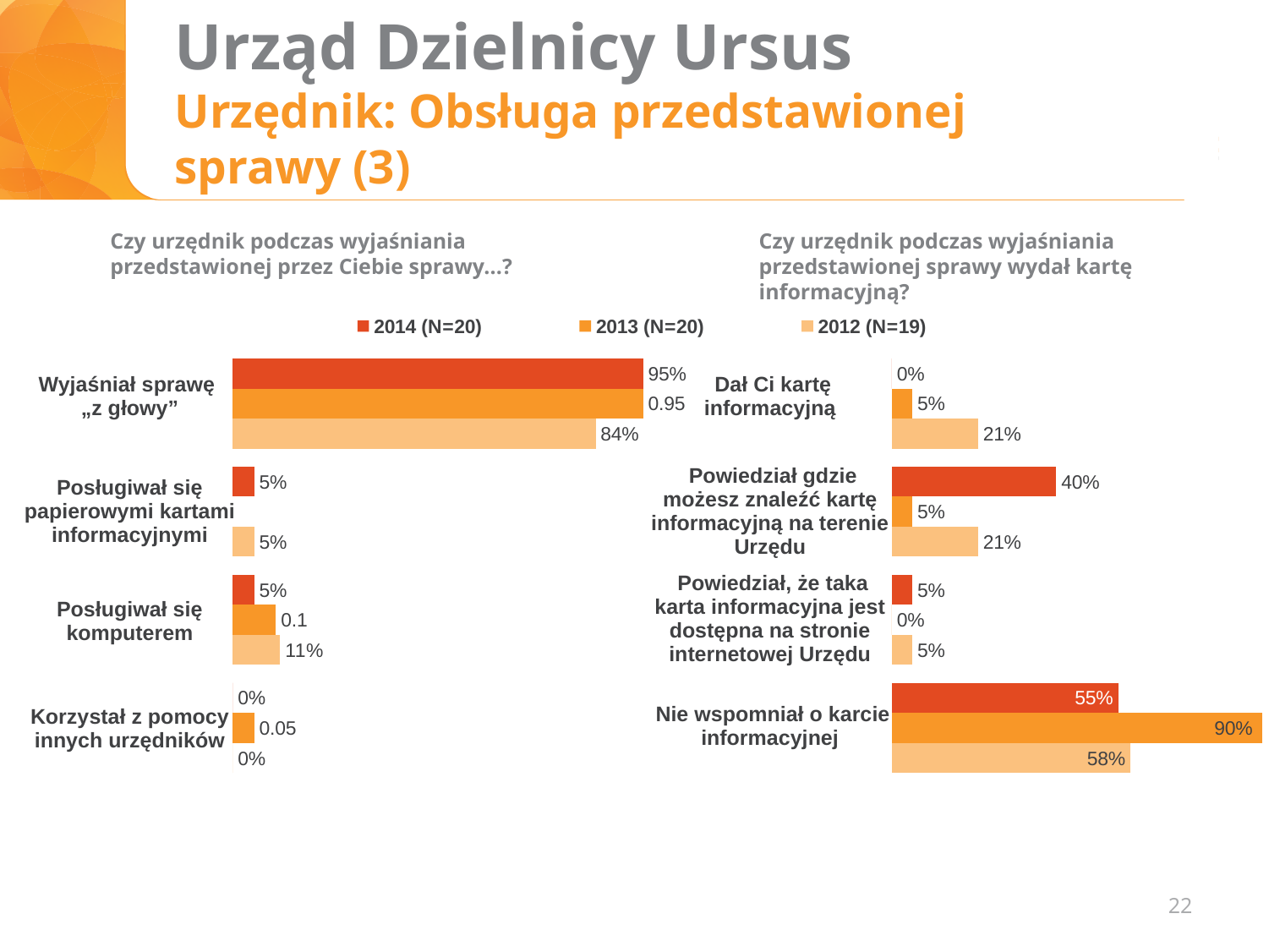
What kind of chart is the right chart? Bar chart In the right chart, what is the difference between the 2013 (N=20) and 2014 (N=20) values for "Nie wspomniał o karcie informacyjnej"? 35% In the right chart, what is the 2012 (N=19) value for "Dał Ci kartę informacyjną"? 21% In the right chart, what is the 2014 (N=20) value for "Powiedział gdzie możesz znaleźć kartę informacyjną na terenie Urzędu"? 40% In the left chart, what is the 2013 (N=20) value for "Korzystał z pomocy innych urzędników"? 0.05 In the left chart, what is the 2012 (N=19) value for "Wyjaśniał sprawę „z głowy”"? 84% In the left chart ("Czy urzędnik podczas wyjaśniania przedstawionej przez Ciebie sprawy...?"), what is the 2014 (N=20) value for "Wyjaśniał sprawę „z głowy”"? 95% In the left chart, which category has the highest 2014 (N=20) value? Wyjaśniał sprawę „z głowy” In the right chart, which is larger for "Nie wspomniał o karcie informacyjnej": the 2014 (N=20) value or the 2012 (N=19) value? 2012 (N=19) In the right chart ("Czy urzędnik podczas wyjaśniania przedstawionej sprawy wydał kartę informacyjną?"), what is the 2013 (N=20) value for "Nie wspomniał o karcie informacyjnej"? 90% How many series does the legend list? 3 In the left chart, what is the 2012 (N=19) value for "Posługiwał się komputerem"? 11%